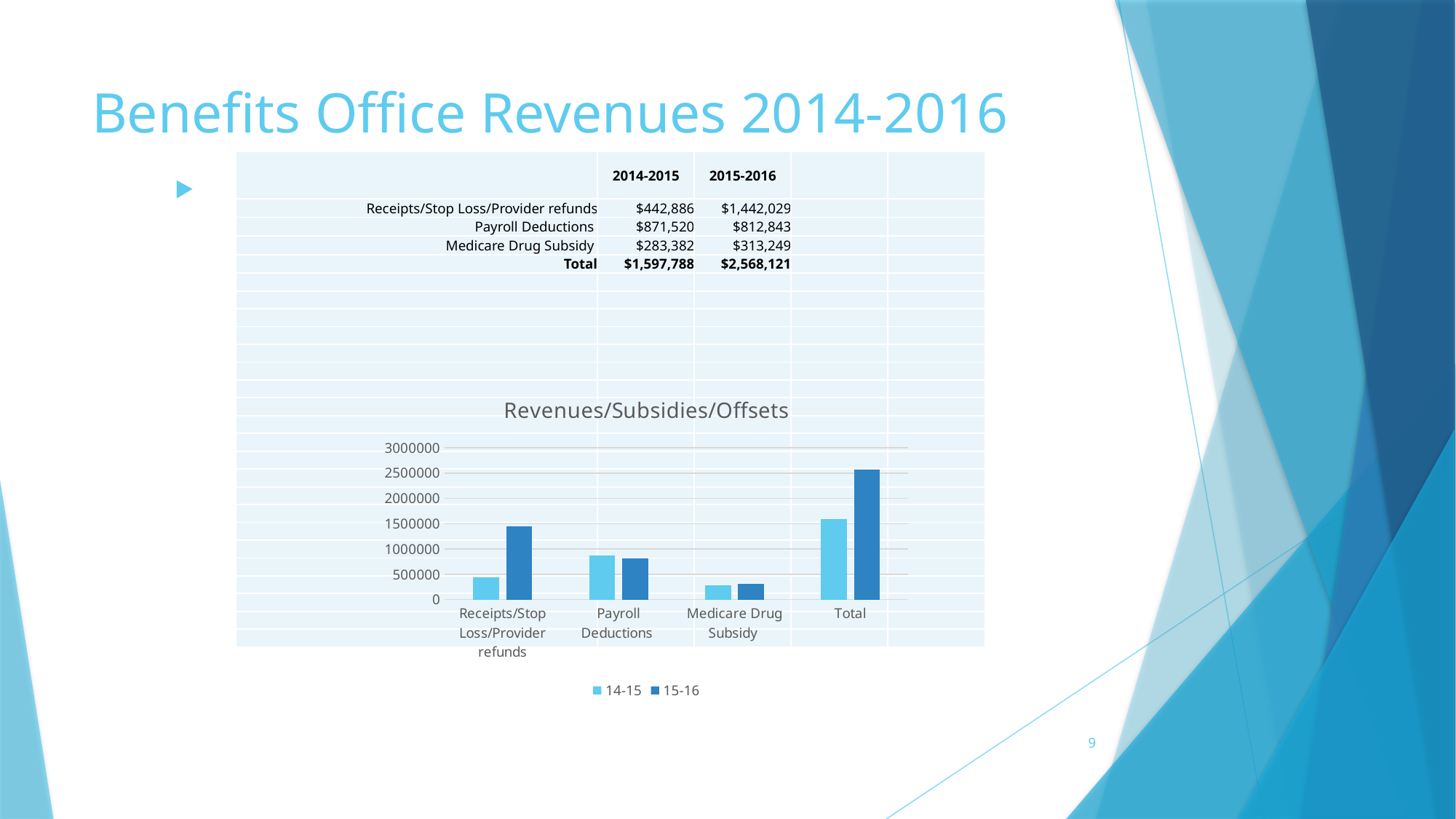
For Payroll Deductions, which series is larger, 14-15 or 15-16? 14-15 How many series does the legend of the Revenues/Subsidies/Offsets chart list? 2 What kind of chart is shown under the title "Revenues/Subsidies/Offsets"? bar chart For Receipts/Stop Loss/Provider refunds, which series is larger, 14-15 or 15-16? 15-16 Excluding Total, which category has the lowest 14-15 value in the chart? Medicare Drug Subsidy What is the title of the chart on the slide? Revenues/Subsidies/Offsets Which category has the tallest 15-16 bar in the Revenues/Subsidies/Offsets chart? Total Is the 15-16 value for Total greater or less than 2500000? greater According to the table on the slide, what is the difference between the 2015-2016 Total and the 2014-2015 Total? $970,333 According to the table on the slide, what is the 2015-2016 value for Receipts/Stop Loss/Provider refunds? $1,442,029 Is the 14-15 value for Receipts/Stop Loss/Provider refunds greater or less than 500000? less How many categories are shown on the x axis of the Revenues/Subsidies/Offsets chart? 4